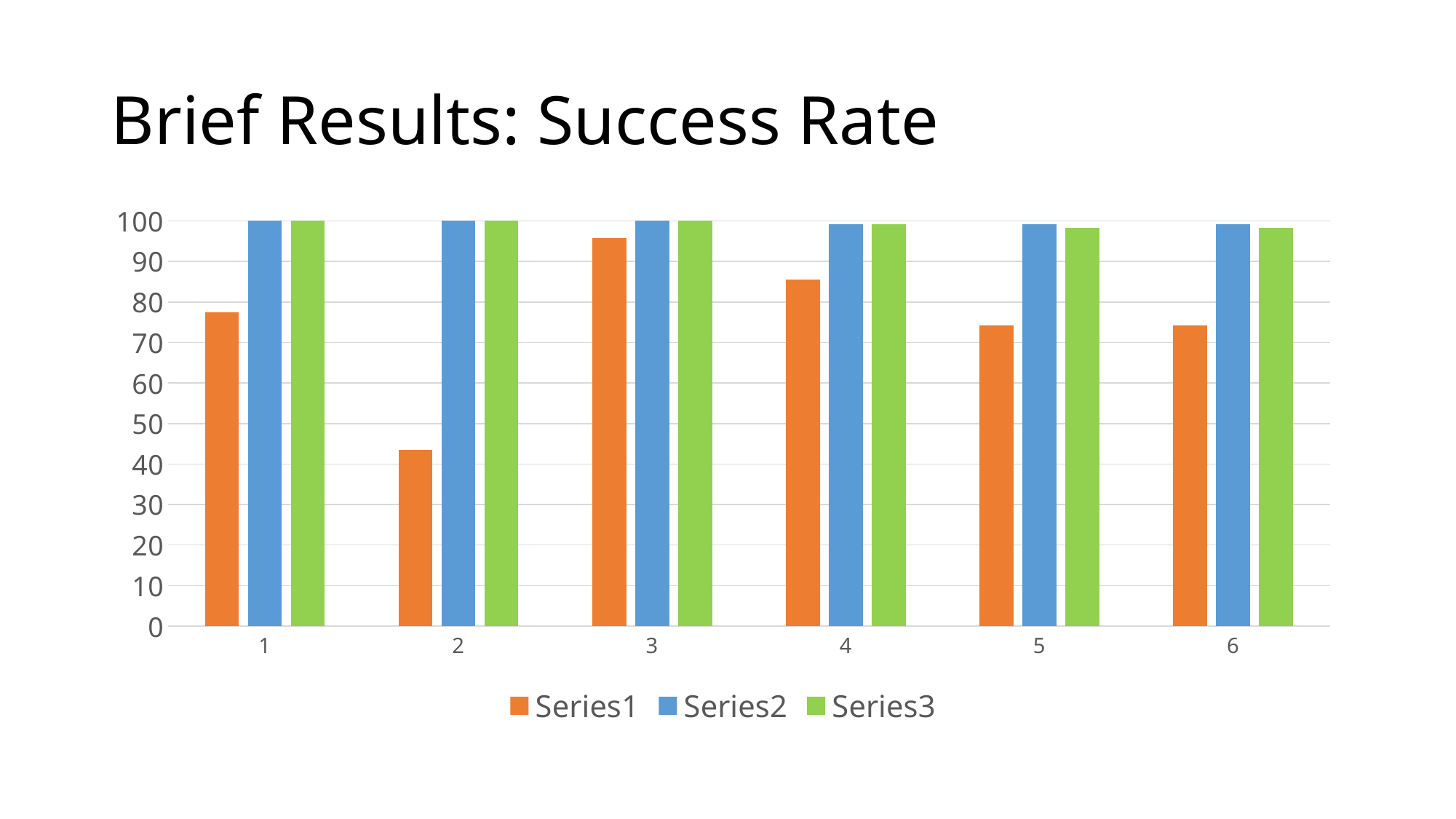
How many series does the legend list? 3 What is the title of the slide? Brief Results: Success Rate For which category is the Series1 value highest? 3 For which category is the Series1 value lowest? 2 What is the value of Series3 for category 2? 100 How many categories are shown on the x axis? 6 Is the value of Series1 for category 3 greater or less than 90? greater Which series is shown in orange? Series1 Which is larger: the Series1 value for category 1 or the Series1 value for category 2? category 1 What is the value of Series2 for category 1? 100 What kind of chart is shown on the slide? bar chart Is the value of Series1 for category 2 greater or less than 50? less